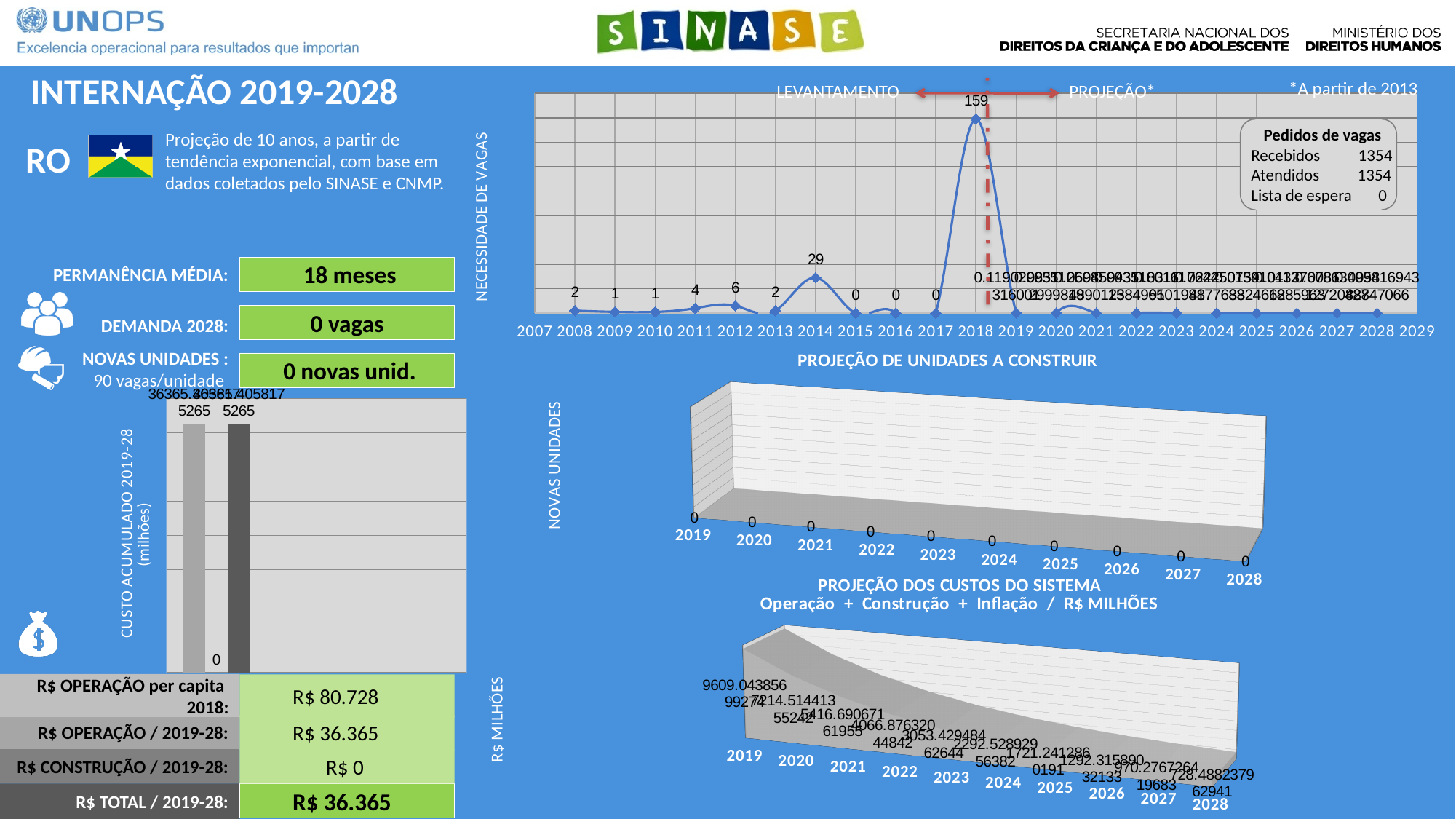
In the PROJEÇÃO DE UNIDADES A CONSTRUIR chart, what is the value for 2025? 0 In the NECESSIDADE DE VAGAS line chart, what is the value for 2018? 159 In the NECESSIDADE DE VAGAS line chart, what is the value for 2016? 0 In the NECESSIDADE DE VAGAS line chart, what is the difference between the value for 2018 and the value for 2014? 130 In the NECESSIDADE DE VAGAS line chart, what is the value for 2012? 6 How many years are shown on the x axis of the PROJEÇÃO DE UNIDADES A CONSTRUIR chart? 10 In the NECESSIDADE DE VAGAS line chart, what is the value for 2014? 29 In the NECESSIDADE DE VAGAS line chart, which is larger, the value for 2014 or the value for 2012? 2014 In the NECESSIDADE DE VAGAS line chart, what is the value for 2011? 4 What kind of chart is the NECESSIDADE DE VAGAS chart at the top right? line chart In the NECESSIDADE DE VAGAS line chart, which year has the highest value? 2018 What kind of chart is the CUSTO ACUMULADO 2019-28 chart on the left of the slide? bar chart